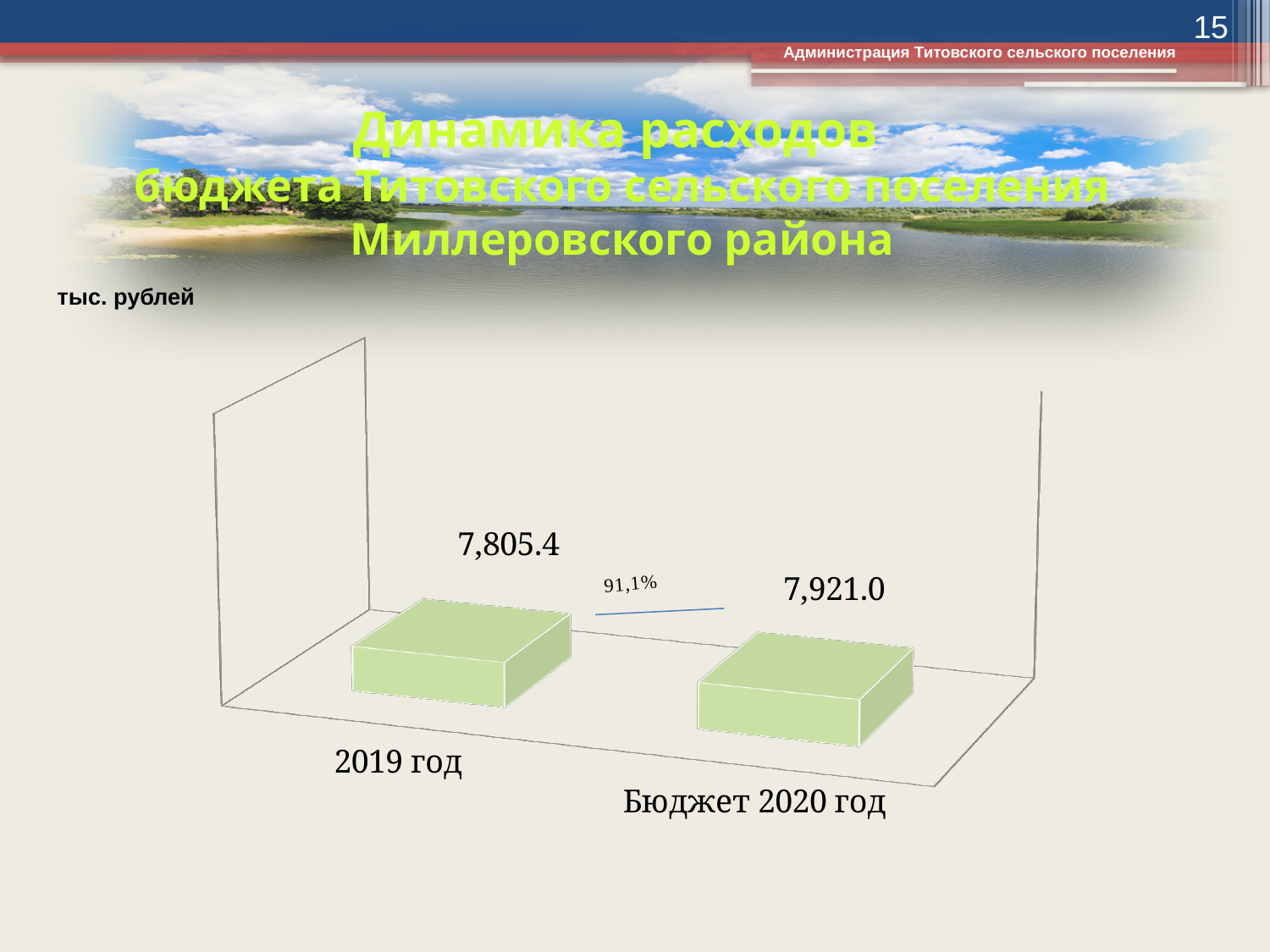
What is the value shown for 2019 год? 7,805.4 Which category has the highest value on the chart? Бюджет 2020 год Which category has the lowest value on the chart? 2019 год In what units are the chart values expressed, according to the label above the chart? тыс. рублей What is the difference between the values for Бюджет 2020 год and 2019 год? 115.6 Do the values rise or fall from 2019 год to Бюджет 2020 год? Rise What is the value shown for Бюджет 2020 год? 7,921.0 What percentage is printed between the two bars on the chart? 91,1% How many categories are plotted on the chart? 2 Which category has the higher value, 2019 год or Бюджет 2020 год? Бюджет 2020 год What kind of chart is shown on the slide? Bar chart